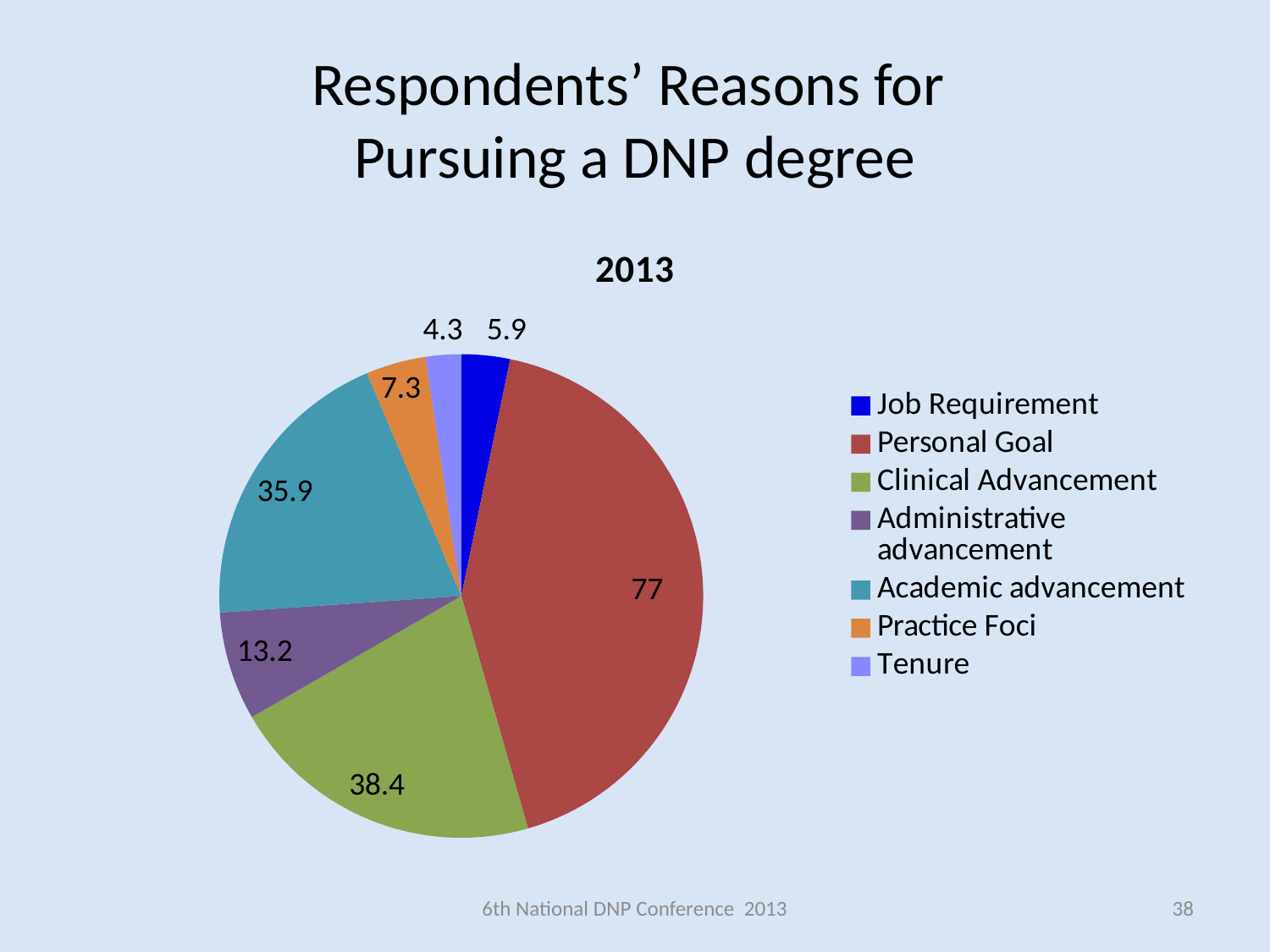
What is the value for Administrative advancement? 13.2 Which reason has the lowest value? Tenure What kind of chart is shown on the slide? pie chart Which is larger, the value for Job Requirement or the value for Practice Foci? Practice Foci What is the value for Personal Goal? 77 What is the value for Clinical Advancement? 38.4 How many categories does the pie chart show? 7 What is the difference between the values for Personal Goal and Clinical Advancement? 38.6 What is the value for Academic advancement? 35.9 What is the title shown above the pie chart? 2013 Which reason has the highest value? Personal Goal What is the value for Tenure? 4.3